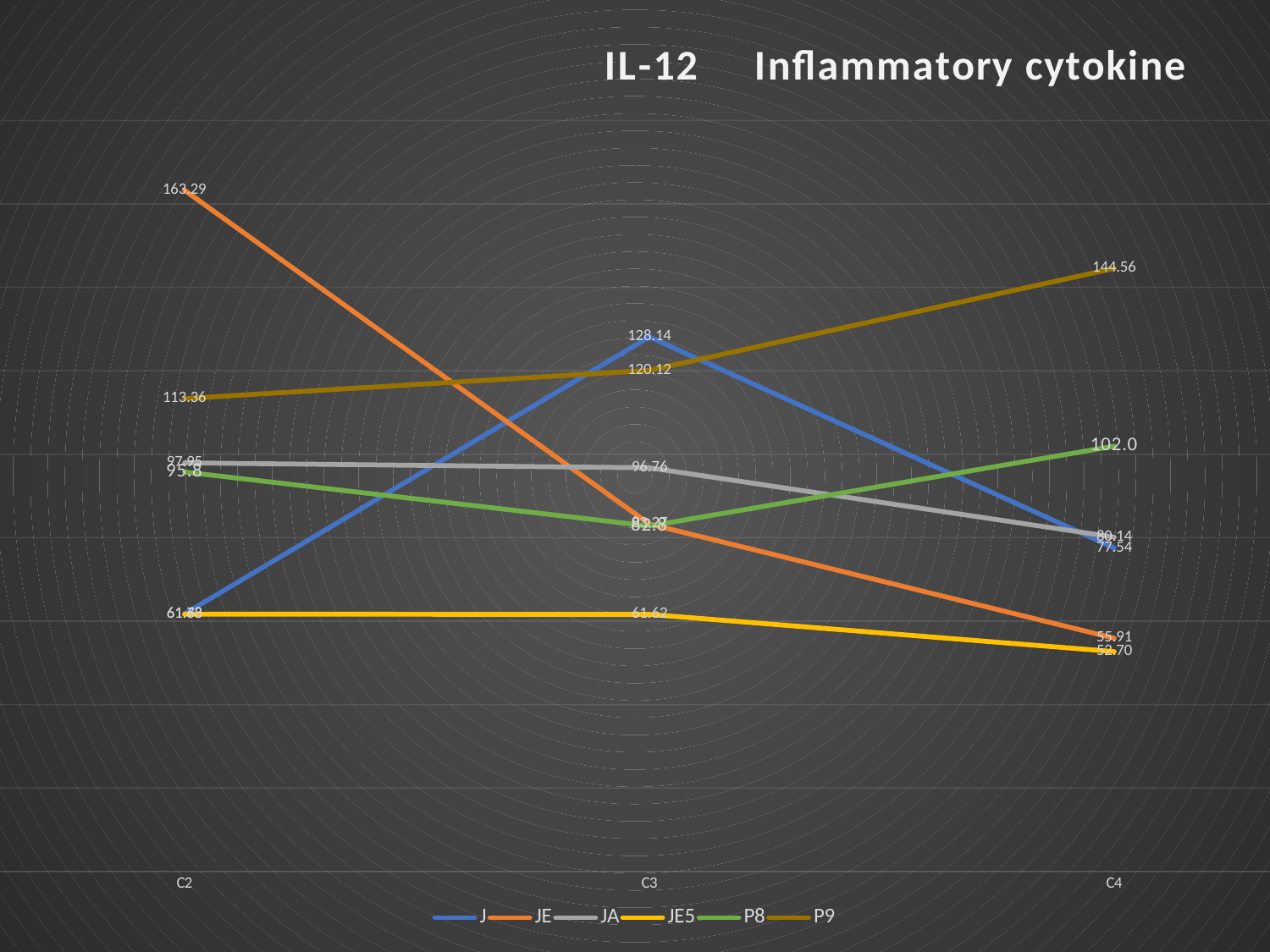
What is the value of JE at C2? 163.29 What is the value of JA at C4? 80.14 What kind of chart is shown on the slide? line chart What is the value of J at C3? 128.14 What is the value of P9 at C4? 144.56 How many series does the legend list? 6 What is the difference between the P9 values at C4 and C2? 31.20 Which is larger at C4, P9 or P8? P9 Which series has the highest value at C4? P9 Which series has the lowest value at C4? JE5 Does the JE series rise or fall from C2 to C4? fall What is the value of JE5 at C4? 52.70